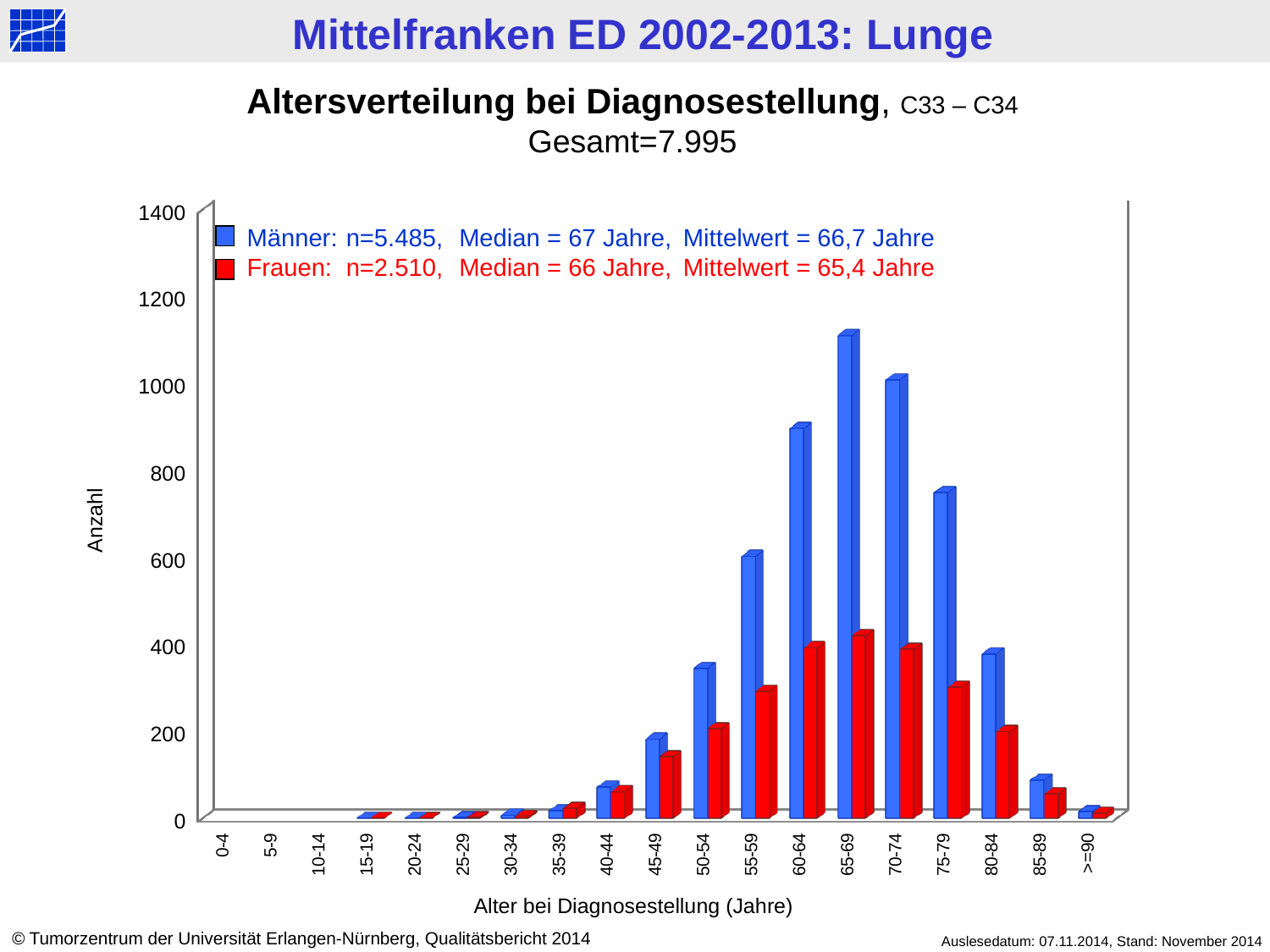
How many series does the legend list? 2 Which age group has the highest value for Männer? 65-69 Is the value for Frauen in the 55-59 age group greater or less than 400? less Do the values for Männer rise or fall from the 65-69 age group to the >=90 age group? fall For Männer, which age group has the larger value, 60-64 or 70-74? 70-74 How many age-group categories are shown on the x axis? 19 In the 65-69 age group, which series has the larger value, Männer or Frauen? Männer Is the value for Männer in the 75-79 age group greater or less than 600? greater Is the value for Männer in the 65-69 age group greater or less than 1000? greater What kind of chart is shown on the slide? bar chart According to the legend, what is the n for Frauen? n=2.510